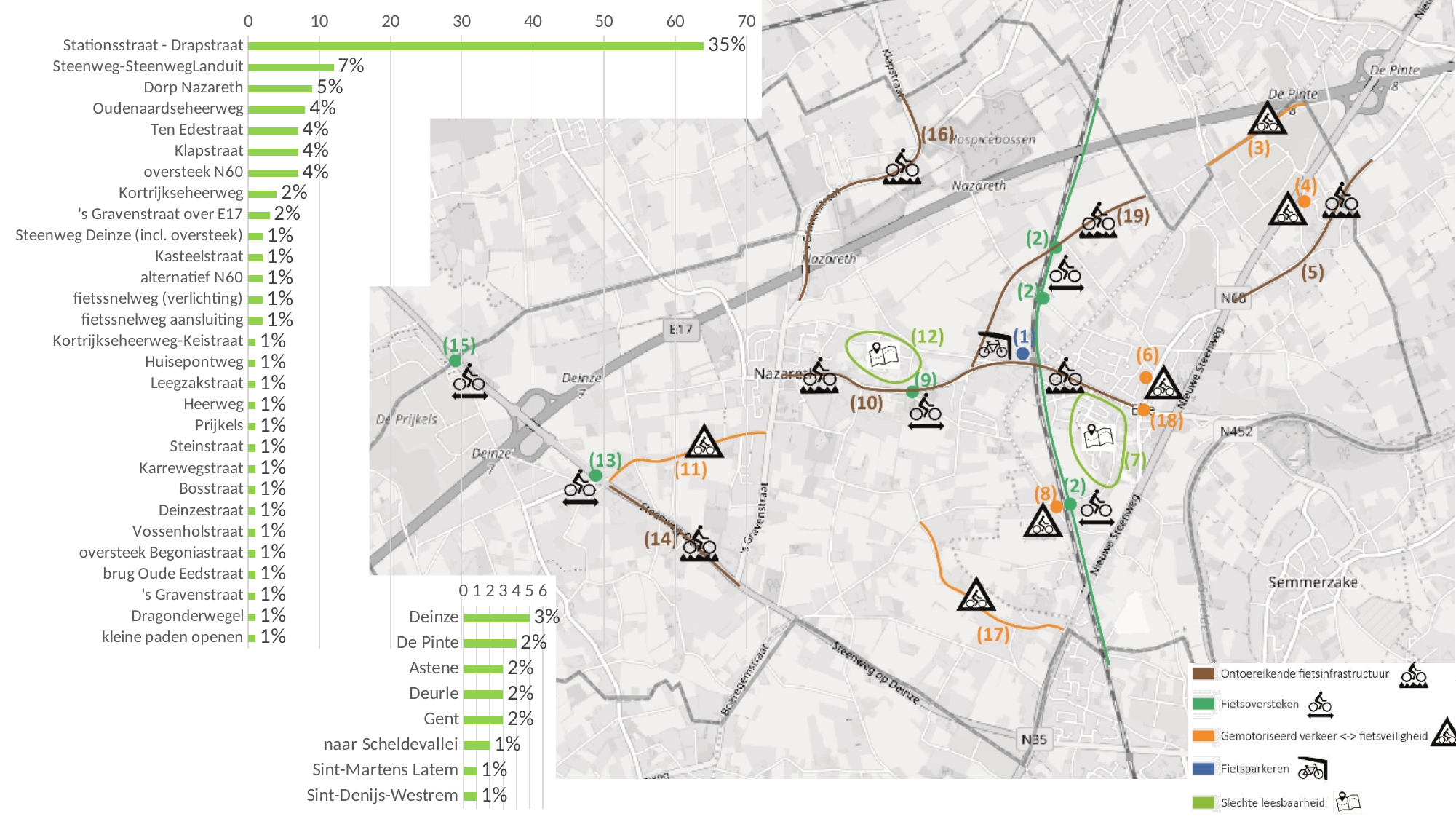
In the large bar chart on the left, what is the difference between Stationsstraat - Drapstraat and Steenweg-SteenwegLanduit? 28% In the large bar chart on the left, what is the value for Stationsstraat - Drapstraat? 35% In the small bar chart at the bottom, what is the difference between Deinze and naar Scheldevallei? 2% What kind of chart is the large chart on the left? Bar chart In the large bar chart on the left, which is larger: Dorp Nazareth or Kortrijkseheerweg? Dorp Nazareth In the small bar chart at the bottom, what is the value for Deinze? 3% How many categories are shown in the large bar chart on the left? 29 How many categories are shown in the small bar chart at the bottom? 8 In the large bar chart on the left, what is the value for Dorp Nazareth? 5% In the large bar chart on the left, what is the value for Steenweg-SteenwegLanduit? 7% In the large bar chart on the left, which category has the highest value? Stationsstraat - Drapstraat In the small bar chart at the bottom, which category has the highest value? Deinze